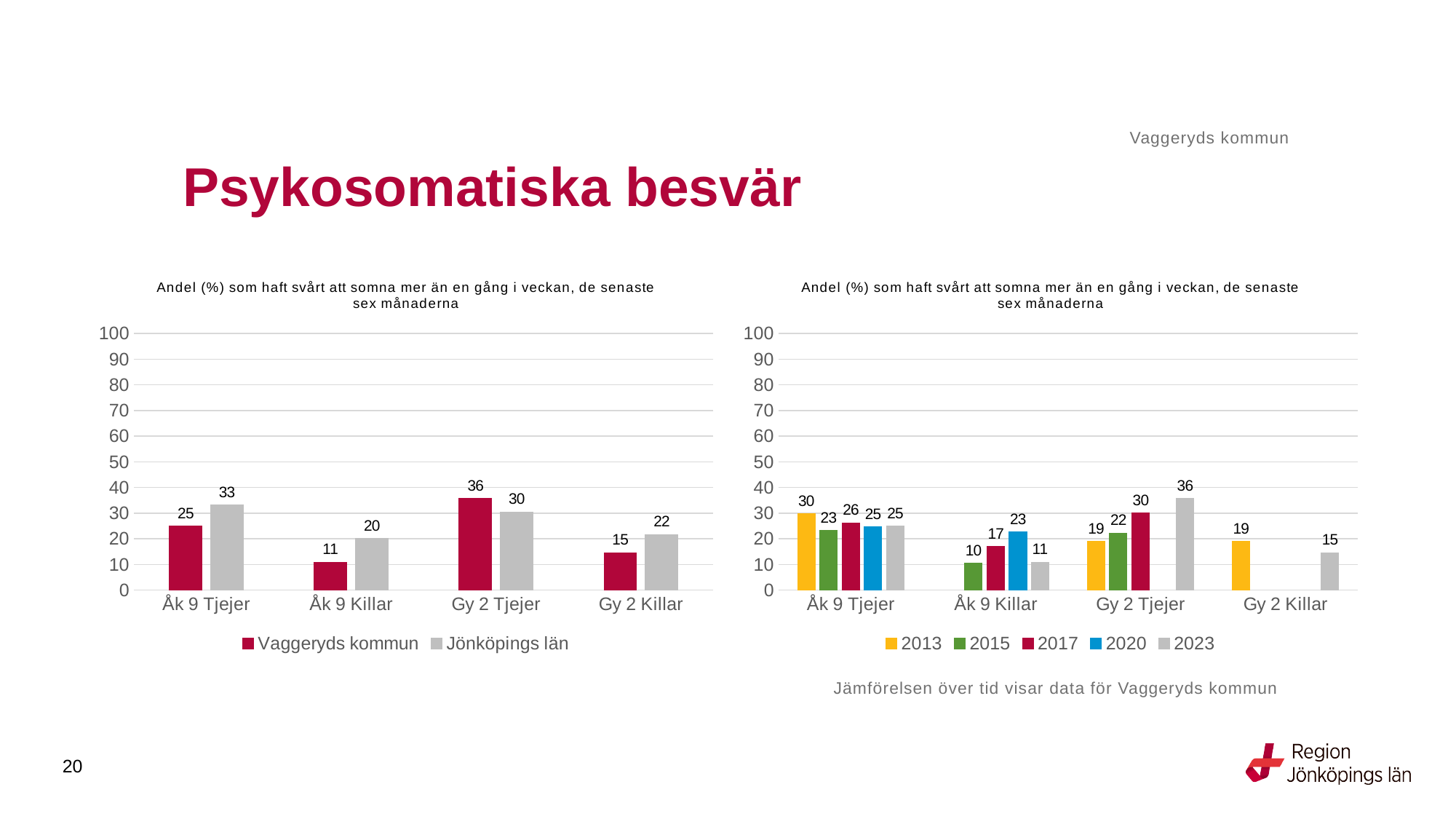
In the left chart, which category has the lowest value for Jönköpings län? Åk 9 Killar What kind of chart is the left chart? Bar chart In the left chart, which is larger for Gy 2 Tjejer: Vaggeryds kommun or Jönköpings län? Vaggeryds kommun How many categories are shown on the x axis of the right chart? 4 How many series does the legend of the right chart list? 5 In the left chart, what is the value for Jönköpings län for Gy 2 Killar? 22 In the left chart, what is the value for Vaggeryds kommun for Åk 9 Tjejer? 25 In the right chart, what is the value for 2023 for Gy 2 Tjejer? 36 In the left chart, what is the difference between Jönköpings län and Vaggeryds kommun for Åk 9 Killar? 9 In the right chart, what is the value for 2020 for Åk 9 Killar? 23 In the right chart, what is the difference between the 2013 and 2023 values for Gy 2 Killar? 4 In the left chart, which category has the highest value for Vaggeryds kommun? Gy 2 Tjejer